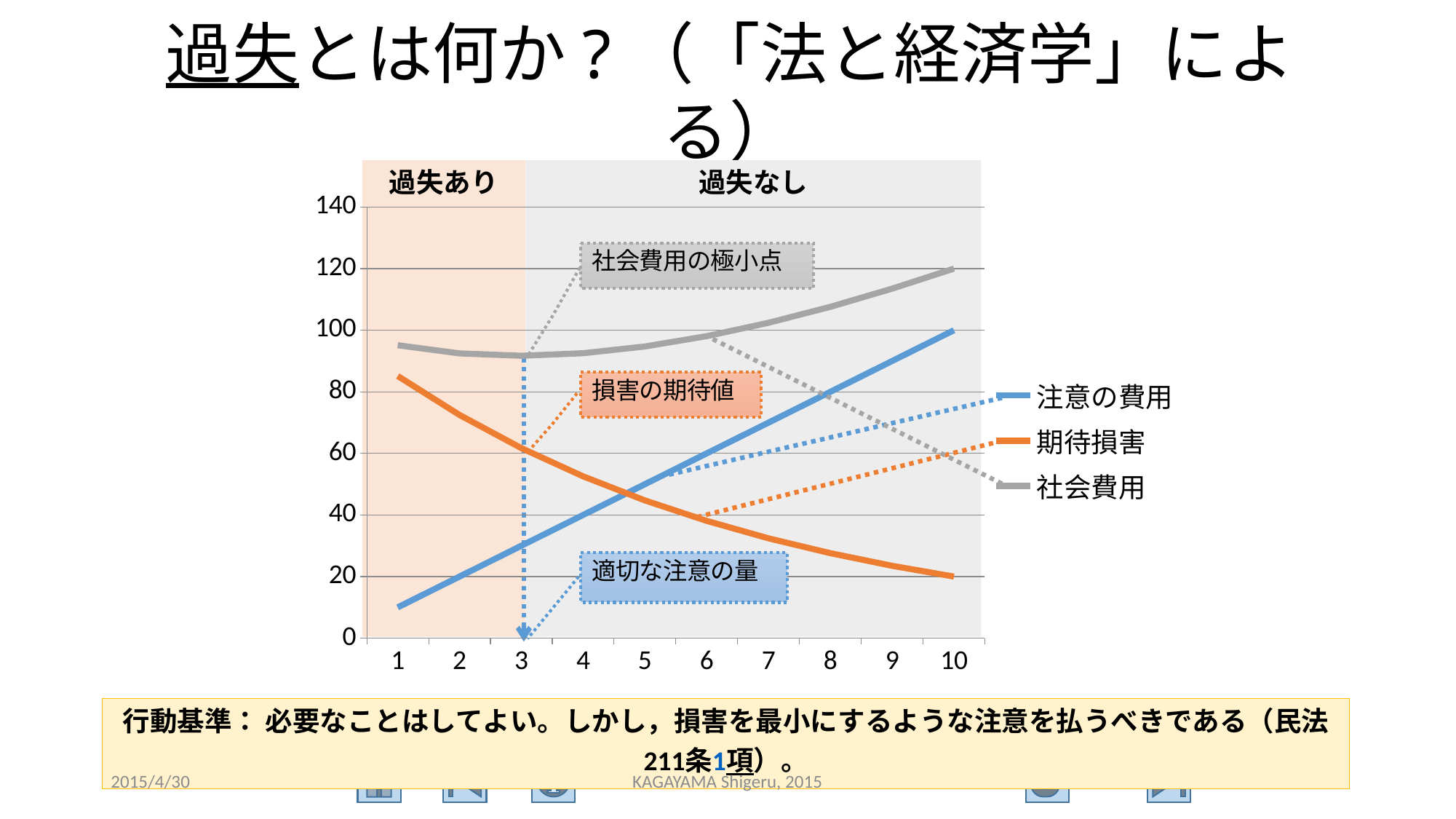
What is the value of 社会費用 at x = 10? 120 How many points are on the x axis of the chart? 10 At x = 9, which is larger, 注意の費用 or 期待損害? 注意の費用 How many series does the legend list? 3 At x = 2, which is larger, 注意の費用 or 期待損害? 期待損害 Is the value of 期待損害 at x = 1 greater or less than 80? greater Which series is drawn in gray in the chart? 社会費用 Does the 期待損害 series rise or fall as the x axis goes from 1 to 10? fall What kind of chart is shown on the slide? line chart Is the value of 注意の費用 at x = 1 greater or less than 20? less What is the value of 期待損害 at x = 10? 20 Does the 注意の費用 series rise or fall as the x axis goes from 1 to 10? rise